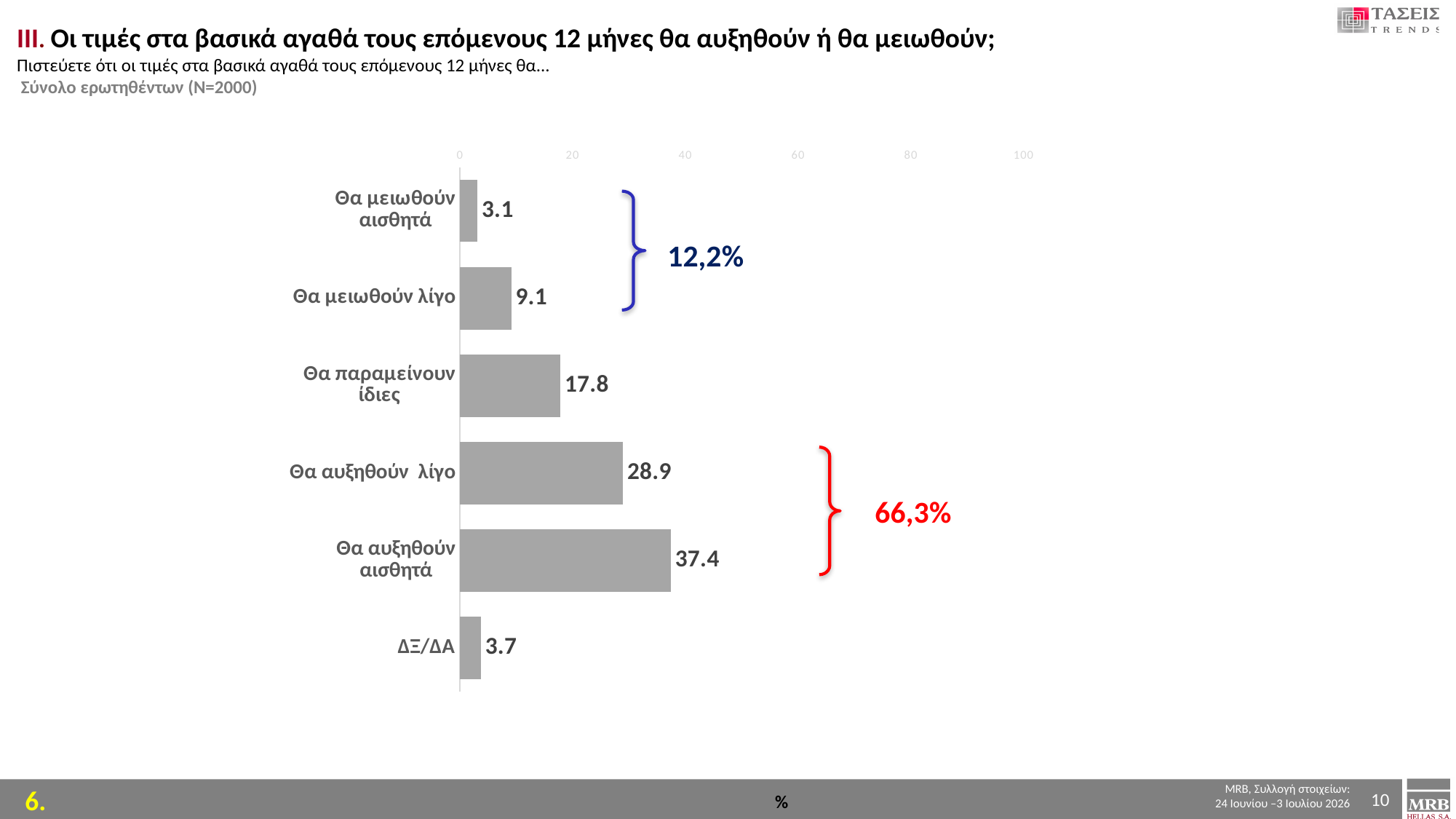
What percentage is shown next to the red bracket grouping the two "Θα αυξηθούν" categories? 66,3% Which category has the highest value? Θα αυξηθούν αισθητά What is the difference between the values for "Θα αυξηθούν αισθητά" and "Θα αυξηθούν λίγο"? 8.5 What is the value for "Θα παραμείνουν ίδιες"? 17.8 Is the value for "Θα αυξηθούν λίγο" greater or less than 20? greater How many categories are shown in the chart? 6 What is the value for "Θα αυξηθούν αισθητά"? 37.4 Which category has the lowest value? Θα μειωθούν αισθητά What kind of chart is shown on the slide? bar chart Which is larger, the value for "Θα μειωθούν λίγο" or the value for "Θα παραμείνουν ίδιες"? Θα παραμείνουν ίδιες What is the value for "ΔΞ/ΔΑ"? 3.7 What percentage is shown next to the blue bracket grouping the two "Θα μειωθούν" categories? 12,2%